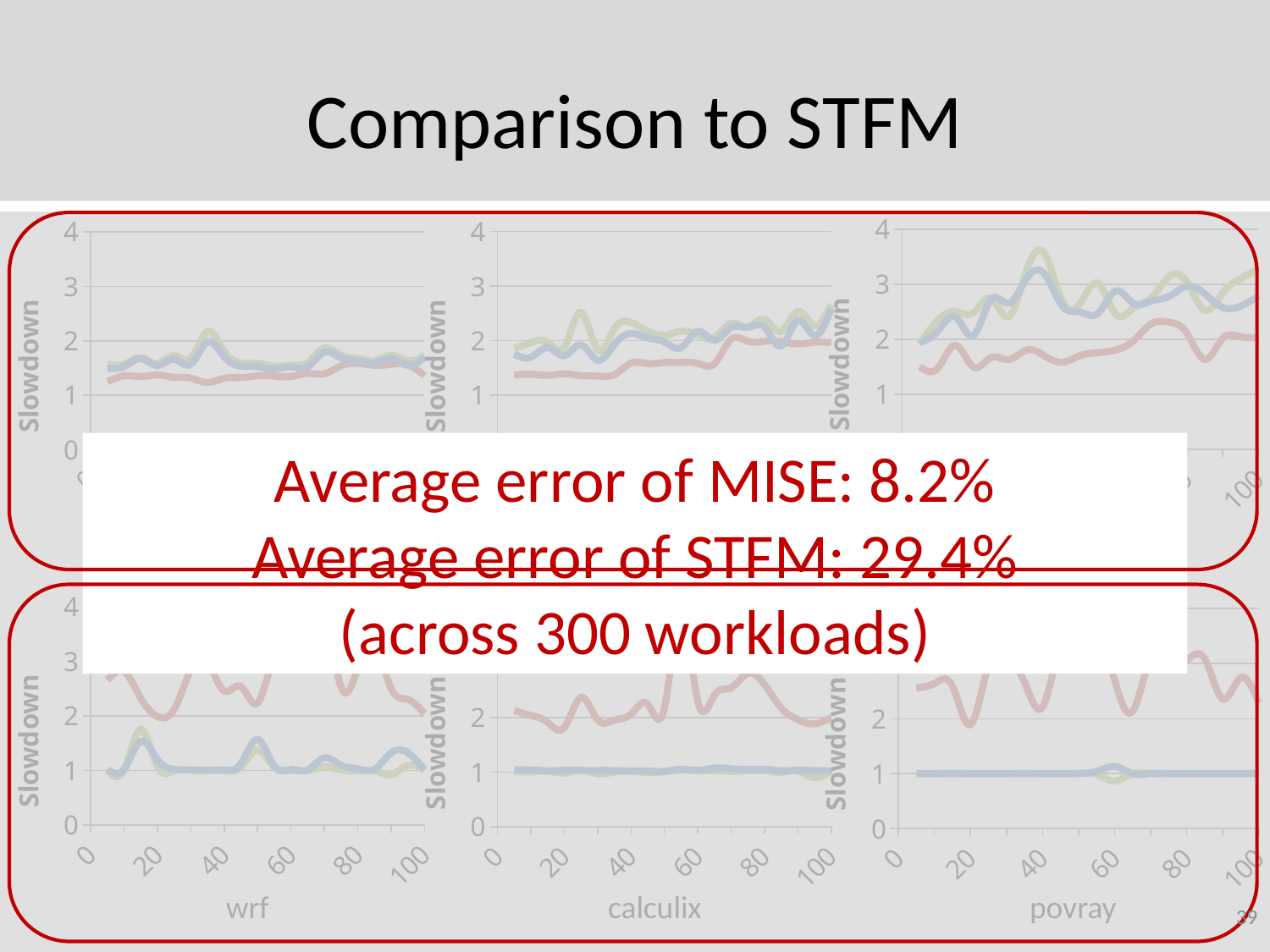
What is the x-axis label of the bottom-right chart? povray How many charts are shown on the slide? 6 What is the label on the y axis of the charts? Slowdown What is the maximum value shown on the y axis of the charts? 4 In the top-left chart, is the value of the red line at x=20 greater or less than 2? less In the bottom calculix chart, is the value of the blue line at x=20 greater or less than 2? less What kind of charts are shown on the slide? Line charts What is the x-axis label of the bottom-left chart? wrf What is the title of the slide containing the charts? Comparison to STFM In the top-right chart, is the peak of the green line near x=40 greater or less than 3? greater How many lines are plotted in each chart? 3 What is the x-axis label of the bottom-middle chart? calculix